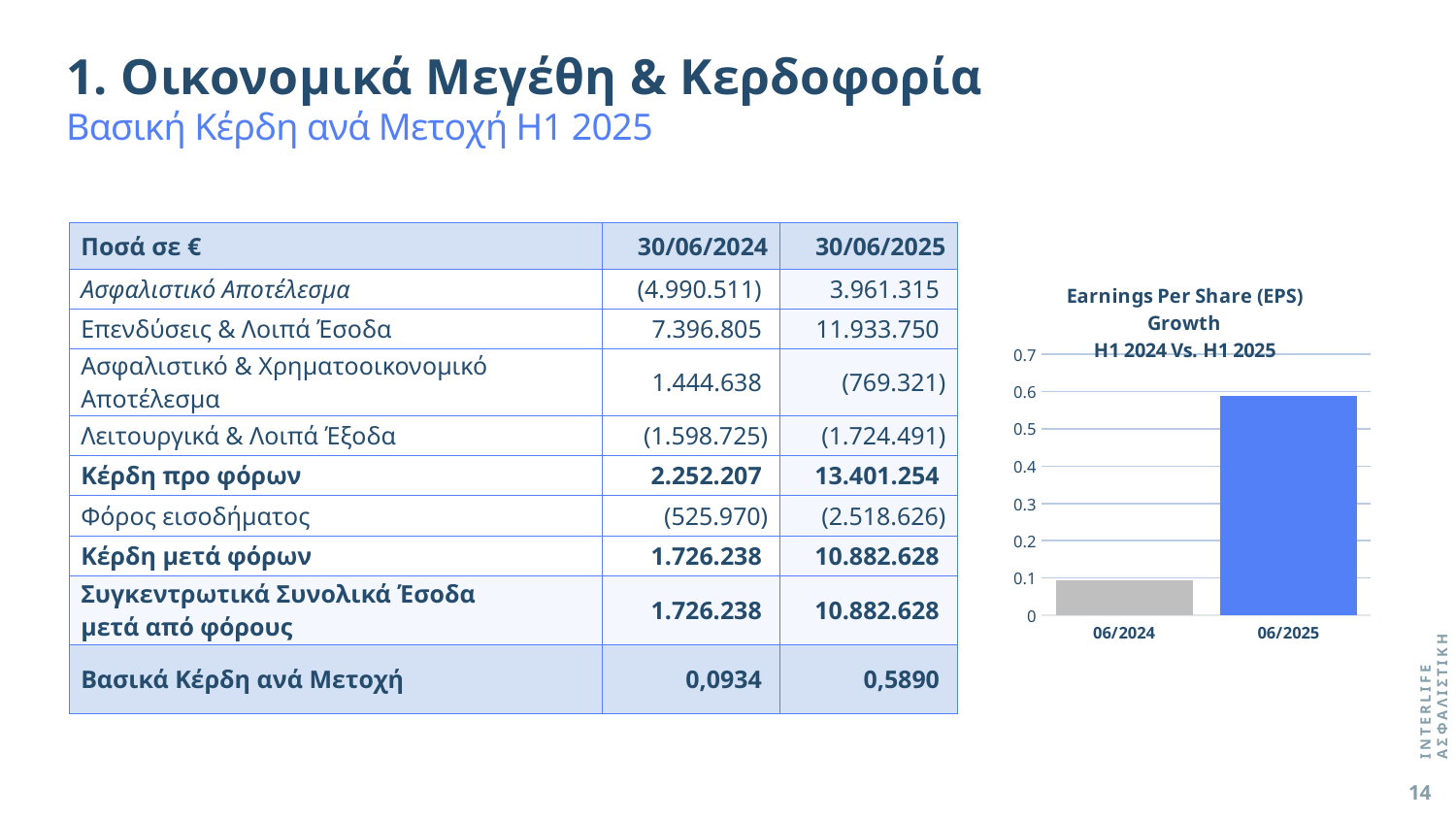
What is the title of the chart on the slide? Earnings Per Share (EPS) Growth H1 2024 Vs. H1 2025 Do the values rise or fall from 06/2024 to 06/2025 in the chart? rise Which category has the lowest bar in the chart? 06/2024 Which is larger in the chart, the value for 06/2024 or the value for 06/2025? 06/2025 What kind of chart is shown on the slide? bar chart How many bars are plotted in the chart? 2 What is the highest tick value shown on the vertical axis of the chart? 0.7 Is the value for 06/2024 greater or less than 0.2? less Is the value for 06/2025 greater or less than 0.5? greater Which category has the highest bar in the chart? 06/2025